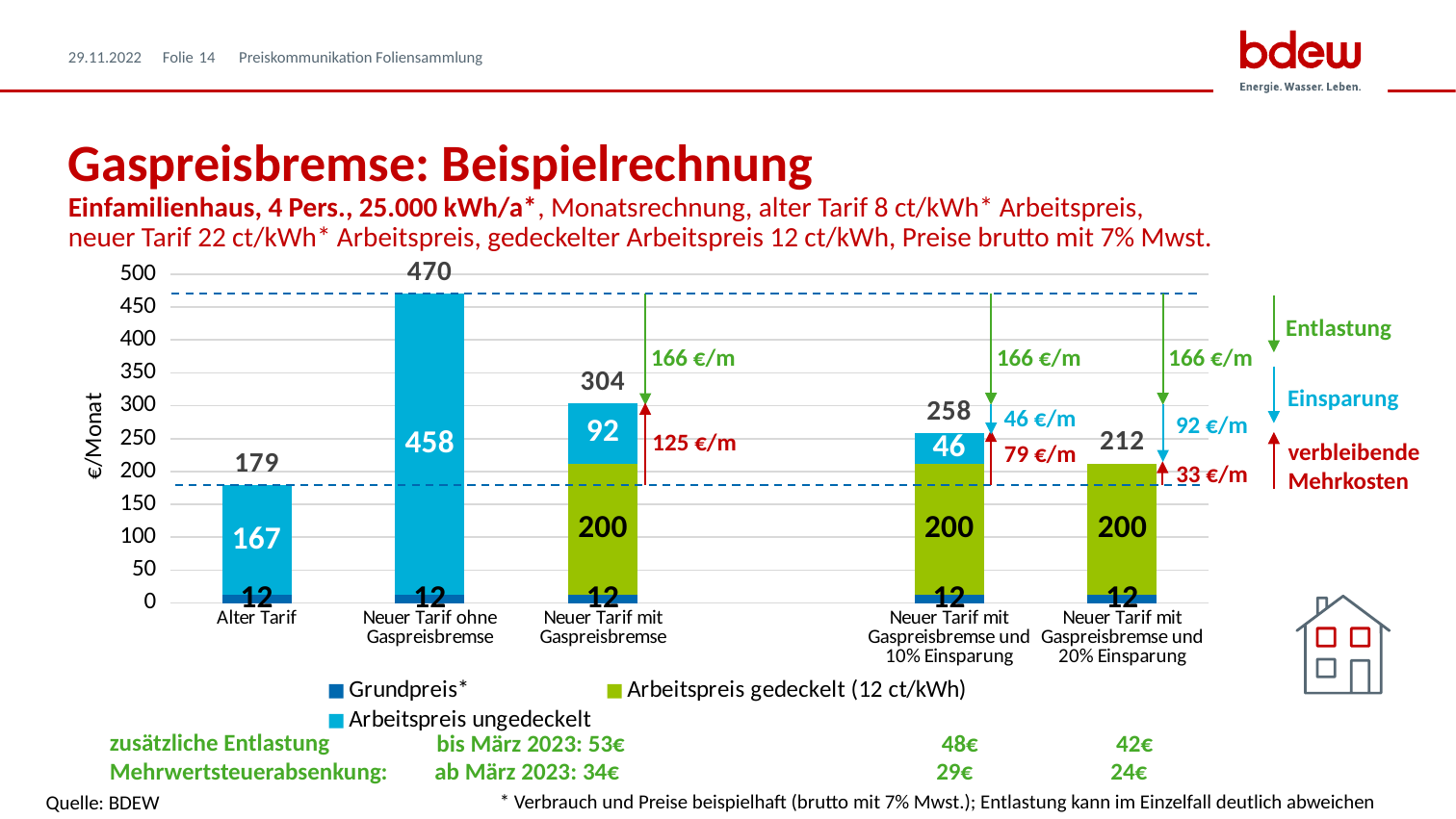
How many bars (categories) are plotted in the chart? 5 What is the label of the y axis? €/Monat What is the 'Arbeitspreis ungedeckelt' value in the 'Alter Tarif' bar? 167 Which category has the lowest total value? Alter Tarif What is the difference between the totals of 'Neuer Tarif ohne Gaspreisbremse' and 'Neuer Tarif mit Gaspreisbremse'? 166 What is the 'Arbeitspreis gedeckelt (12 ct/kWh)' value in the 'Neuer Tarif mit Gaspreisbremse' bar? 200 What is the 'Grundpreis*' value in each bar? 12 What type of chart is shown on the slide? stacked bar chart Which is larger: the total for 'Neuer Tarif mit Gaspreisbremse und 10% Einsparung' or the total for 'Neuer Tarif mit Gaspreisbremse und 20% Einsparung'? Neuer Tarif mit Gaspreisbremse und 10% Einsparung How many series does the chart legend list? 3 What is the total value shown above the bar for 'Neuer Tarif ohne Gaspreisbremse'? 470 Which category has the highest total value? Neuer Tarif ohne Gaspreisbremse